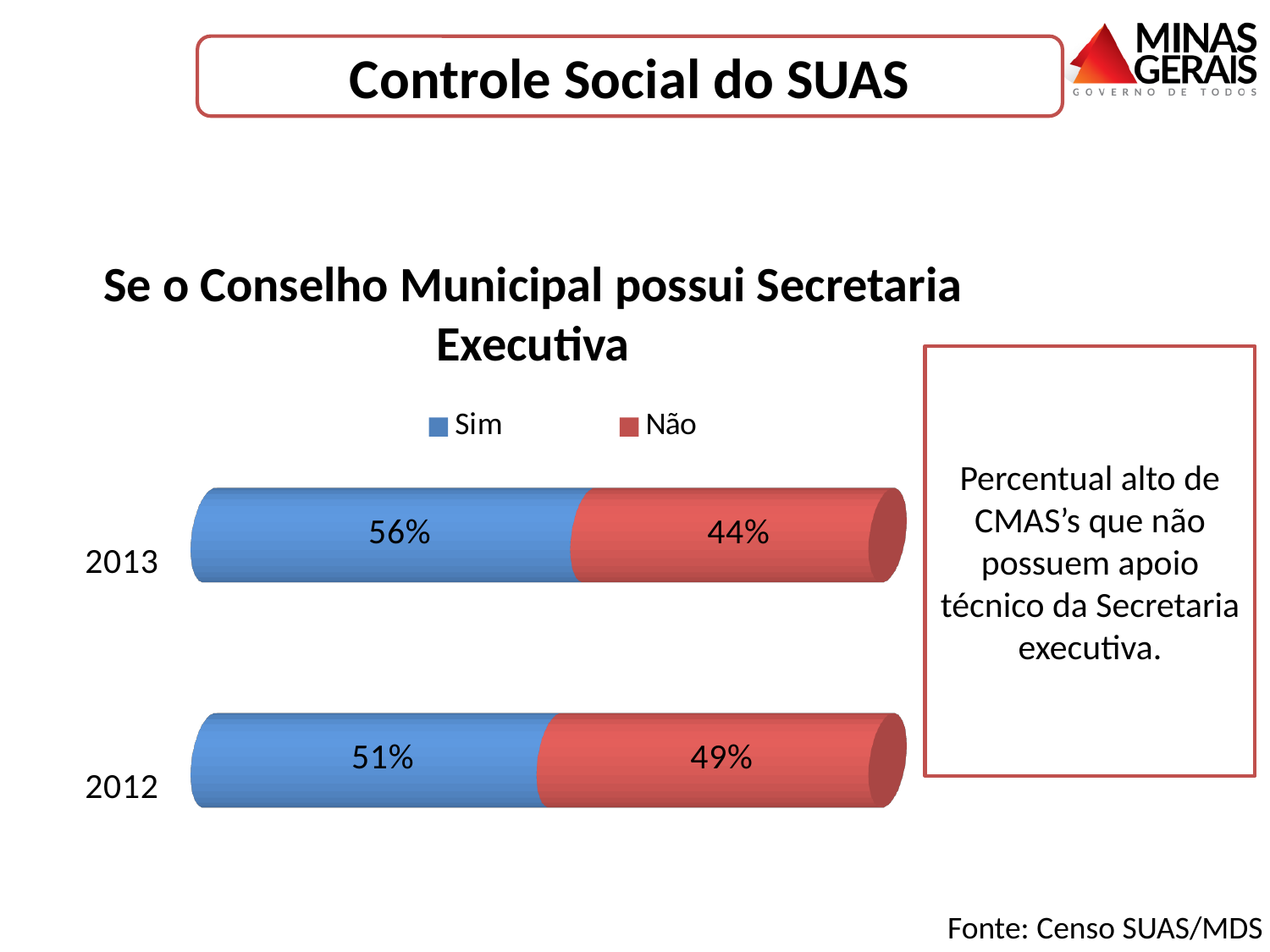
Which year has the lower value for Não? 2013 How many years are shown on the chart? 2 What is the value for Não in 2012? 49% What is the value for Não in 2013? 44% What is the value for Sim in 2013? 56% What is the difference between the Sim values for 2013 and 2012? 5% How many series does the legend list? 2 Which year has the higher value for Sim? 2013 In 2012, which is larger, Sim or Não? Sim What kind of chart is shown? Stacked bar chart What is the value for Sim in 2012? 51% What is the title of the chart? Se o Conselho Municipal possui Secretaria Executiva